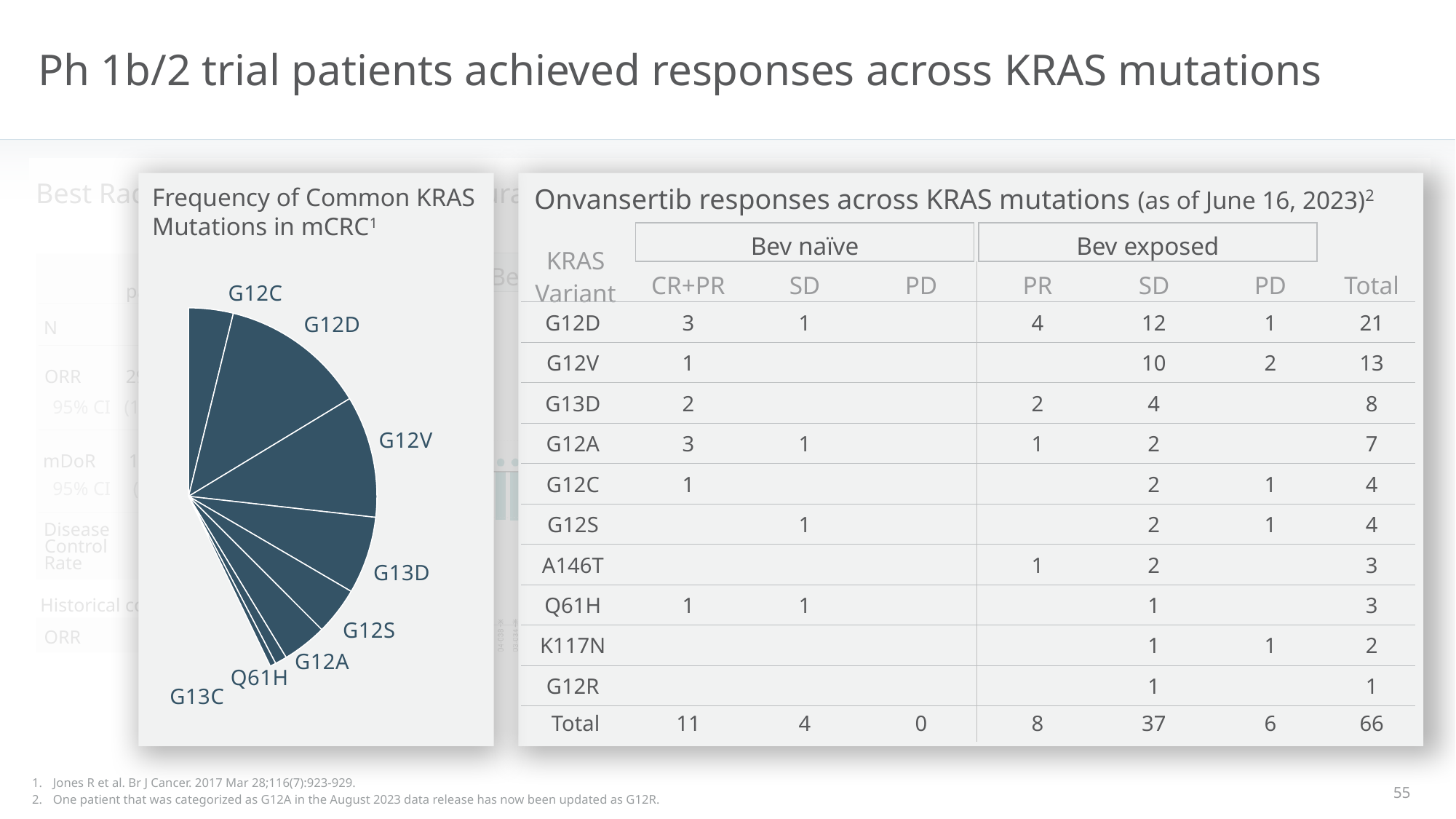
How many KRAS mutation slices are labelled in the "Frequency of Common KRAS Mutations in mCRC" pie chart? 8 What is the title of the pie chart on the left of the slide? Frequency of Common KRAS Mutations in mCRC In the "Frequency of Common KRAS Mutations in mCRC" pie chart, which slice is larger, G13D or Q61H? G13D In the "Frequency of Common KRAS Mutations in mCRC" pie chart, which slice is larger, G12V or G12S? G12V What kind of chart is the "Frequency of Common KRAS Mutations in mCRC" chart? pie chart In the "Frequency of Common KRAS Mutations in mCRC" pie chart, which slice is larger, G12D or G13C? G12D What colour are the slices of the "Frequency of Common KRAS Mutations in mCRC" pie chart? dark blue